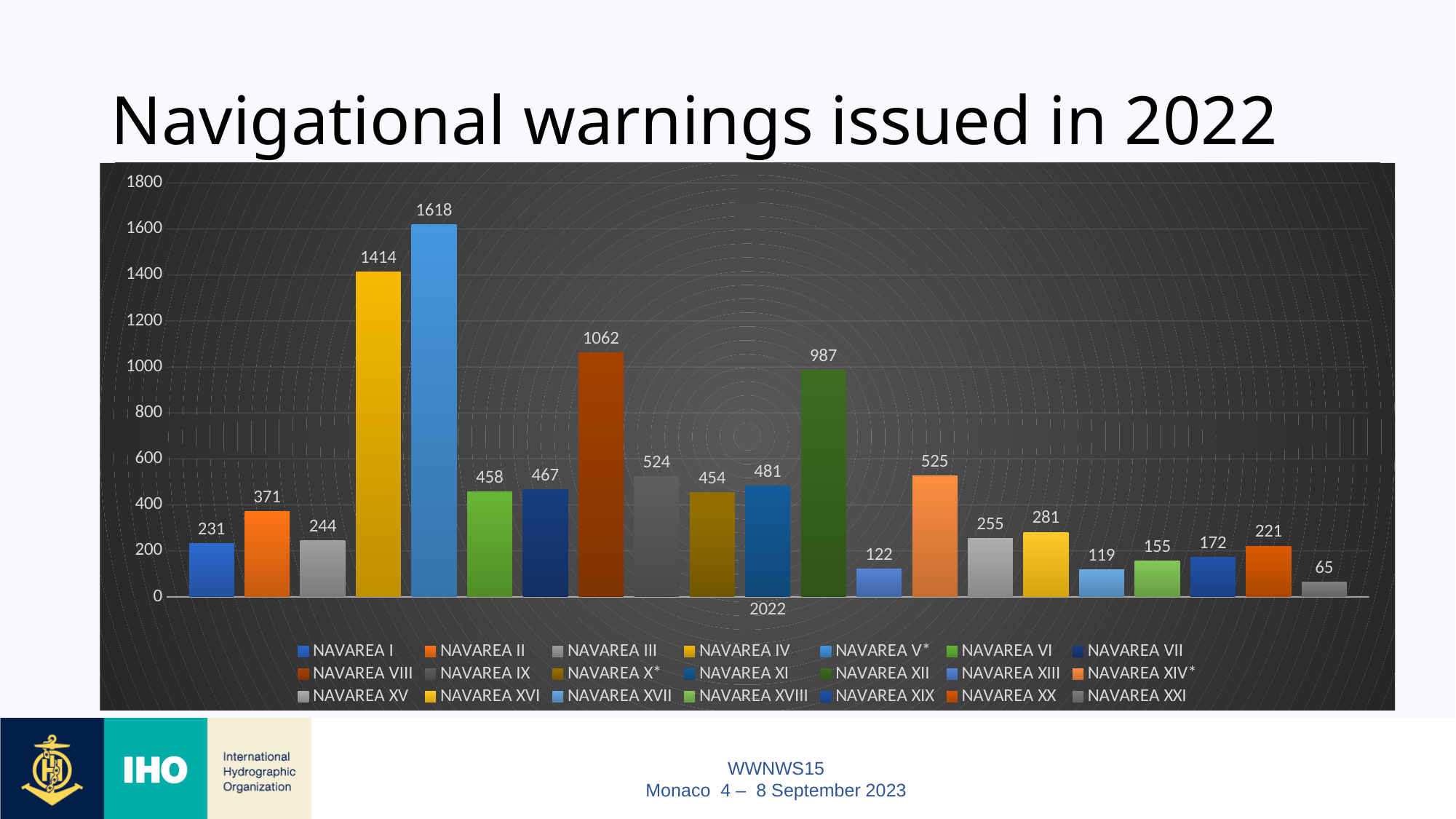
What is the value for NAVAREA XIII? 122 Which is larger, the value for NAVAREA XII or the value for NAVAREA VIII? NAVAREA VIII Which NAVAREA has the lowest number of navigational warnings issued? NAVAREA XXI How many series does the legend list? 21 What is the value for NAVAREA VIII? 1062 What is the value for NAVAREA XVI? 281 What is the difference between the values for NAVAREA V* and NAVAREA IV? 204 What is the title of the chart? Navigational warnings issued in 2022 What is the value for NAVAREA V*? 1618 Which NAVAREA has the highest number of navigational warnings issued? NAVAREA V* What kind of chart is shown on the slide? bar chart What is the difference between the values for NAVAREA XIV* and NAVAREA XV? 270